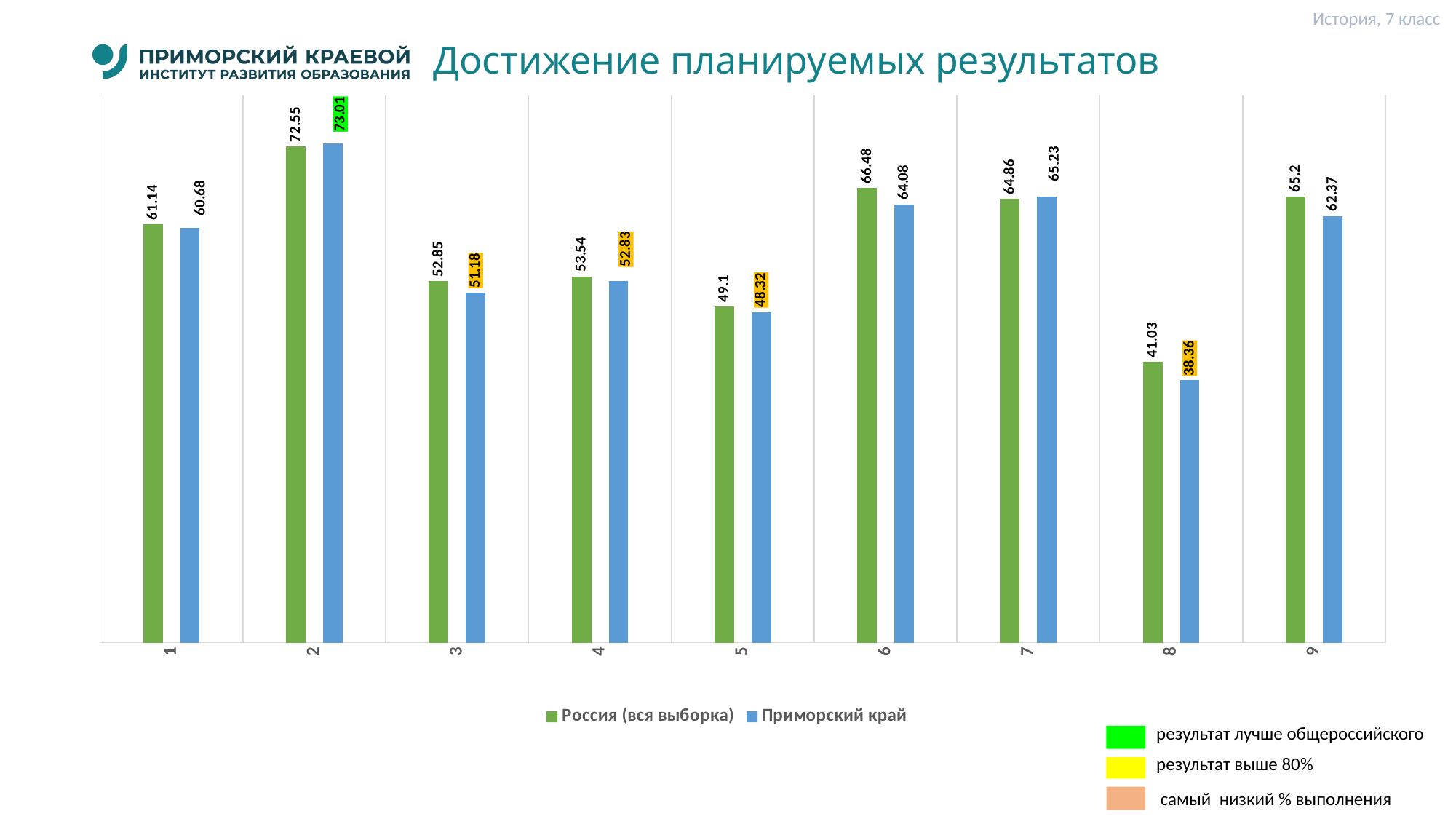
What is the value for Россия (вся выборка) for category 8? 41.03 What kind of chart is shown on the slide? Bar chart What is the title of the slide's chart? Достижение планируемых результатов For category 7, which series has the larger value: Россия (вся выборка) or Приморский край? Приморский край For category 6, which series has the larger value: Россия (вся выборка) or Приморский край? Россия (вся выборка) Which category has the highest value for Россия (вся выборка)? 2 What is the difference between Россия (вся выборка) and Приморский край for category 8? 2.67 How many series does the chart legend list? 2 What is the value for Приморский край for category 5? 48.32 How many categories are shown on the x axis? 9 Which category has the lowest value for Приморский край? 8 What is the value for Приморский край for category 2? 73.01